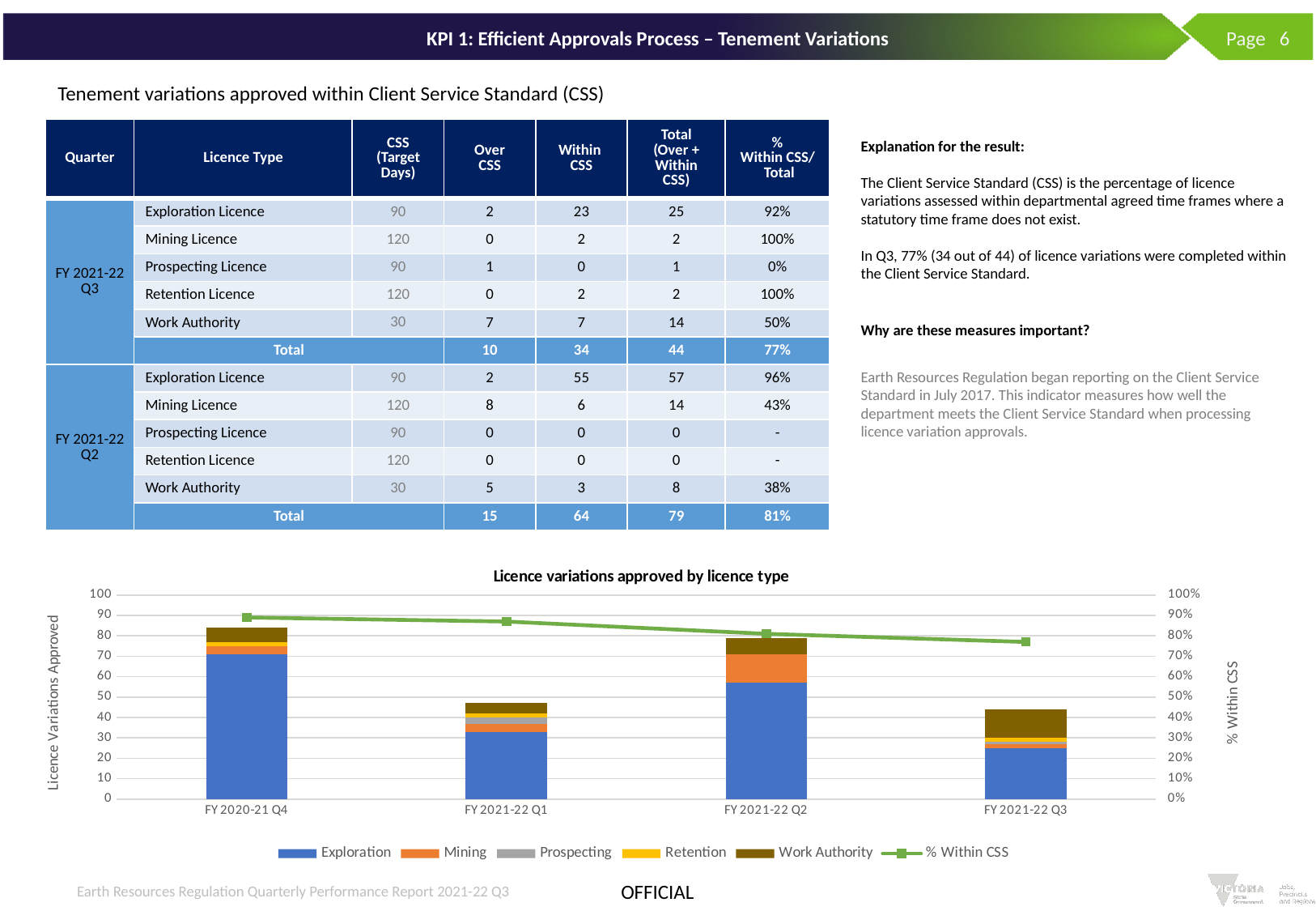
In the 'Licence variations approved by licence type' chart, which quarter has the largest Mining segment? FY 2021-22 Q2 In the 'Licence variations approved by licence type' chart, which quarter has the tallest stacked bar? FY 2020-21 Q4 How many quarters are shown on the x axis of the 'Licence variations approved by licence type' chart? 4 In the 'Licence variations approved by licence type' chart, is the Exploration segment larger in FY 2020-21 Q4 or in FY 2021-22 Q2? FY 2020-21 Q4 In the 'Licence variations approved by licence type' chart, does the % Within CSS line rise or fall from FY 2020-21 Q4 to FY 2021-22 Q3? Fall In the 'Licence variations approved by licence type' chart, which quarter has the lowest % Within CSS value? FY 2021-22 Q3 In the 'Licence variations approved by licence type' chart, is the total stacked bar for FY 2020-21 Q4 greater or less than 80? greater What is the label of the right-hand vertical axis of the 'Licence variations approved by licence type' chart? % Within CSS How many series does the legend of the 'Licence variations approved by licence type' chart list? 6 In the 'Licence variations approved by licence type' chart, is the % Within CSS value for FY 2021-22 Q3 greater or less than 80%? less In the 'Licence variations approved by licence type' chart, is the total stacked bar for FY 2021-22 Q1 greater or less than 50? less What kind of chart is 'Licence variations approved by licence type'? A stacked bar chart with a line